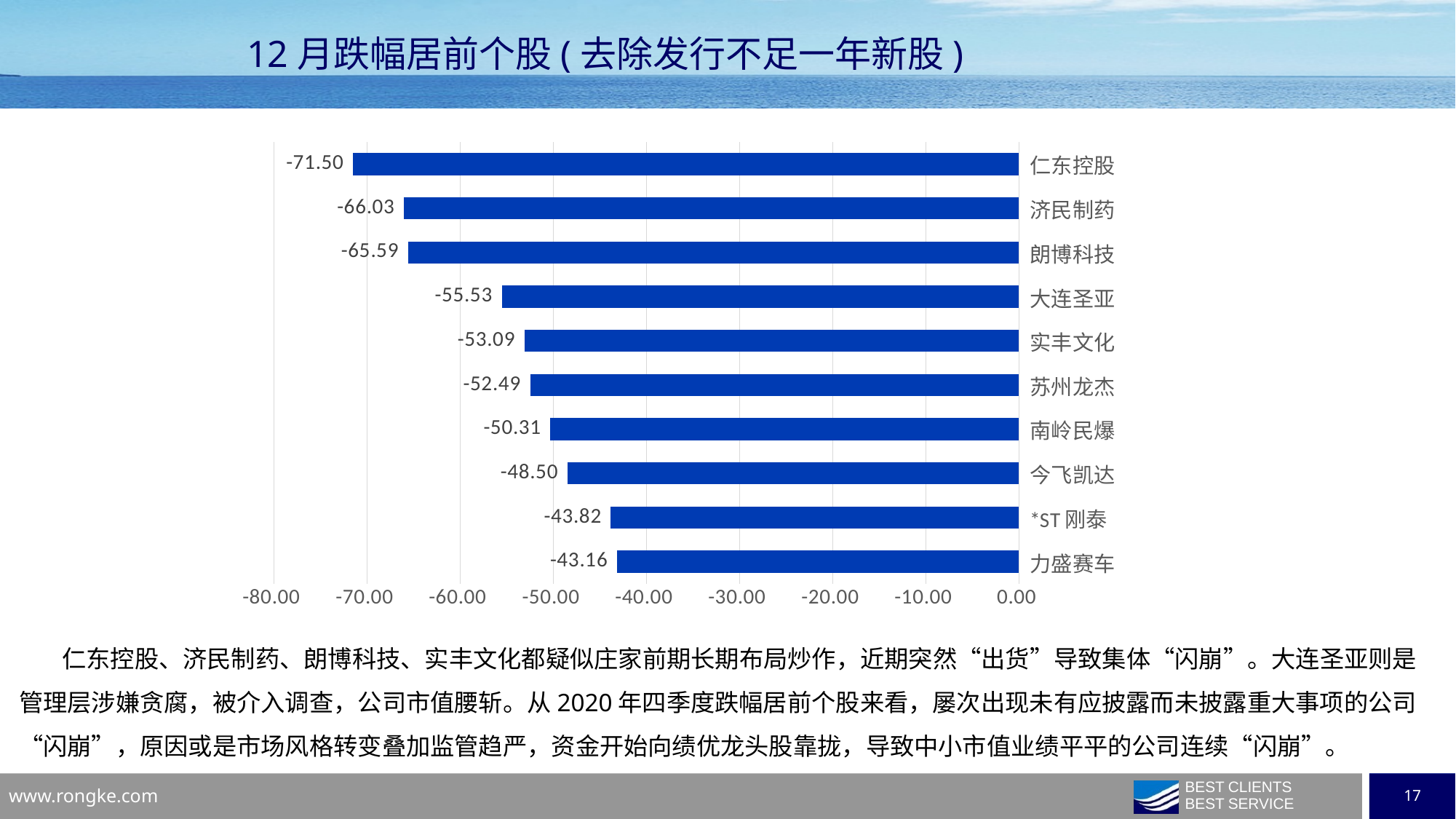
What is the difference between the values for 大连圣亚 and 实丰文化? 2.44 What is the value shown for 大连圣亚? -55.53 Is the value for 今飞凯达 greater or less than -50.00? greater Which stock has the smallest decline (the least negative value) in the chart? 力盛赛车 What is the difference between the values for 仁东控股 and 力盛赛车? 28.34 Which stock has the largest decline (the most negative value) in the chart? 仁东控股 Which stock fell more, 济民制药 or 朗博科技? 济民制药 What is the value shown for 苏州龙杰? -52.49 What is the value shown for *ST 刚泰? -43.82 What kind of chart is shown on the slide? bar chart What is the value shown for 仁东控股? -71.50 How many stocks are shown in the chart? 10